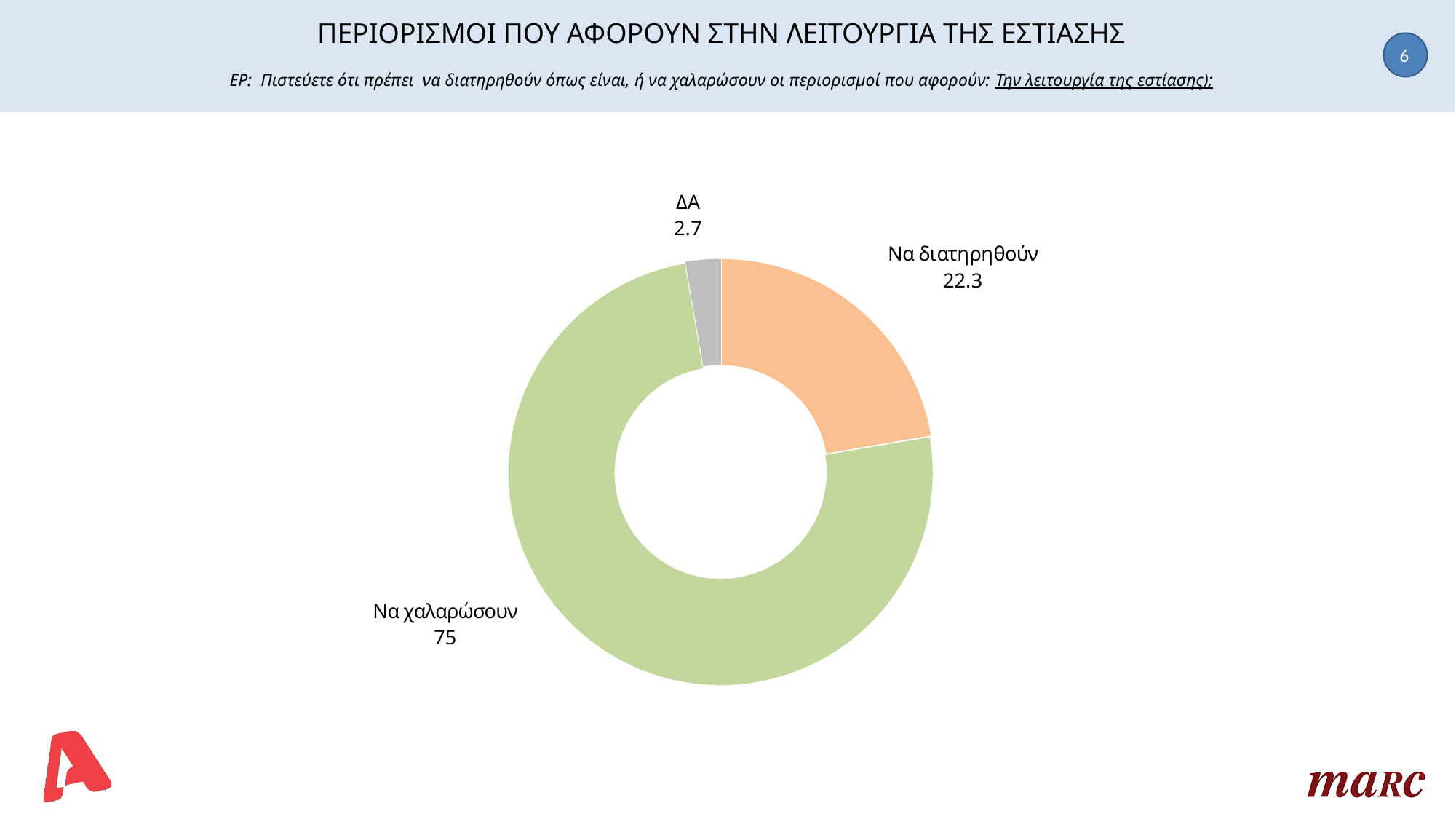
What kind of chart is shown on the slide? Doughnut (pie) chart What is the total of the three values shown in the chart? 100 What colour is the segment for Να χαλαρώσουν? Green Which category has the largest share of the chart? Να χαλαρώσουν Which is larger, the value for Να διατηρηθούν or the value for ΔΑ? Να διατηρηθούν What is the difference between the values for Να διατηρηθούν and ΔΑ? 19.6 What value is shown for Να χαλαρώσουν? 75 Which category has the smallest share of the chart? ΔΑ What value is shown for ΔΑ? 2.7 How many categories are shown in the chart? 3 What value is shown for Να διατηρηθούν? 22.3 What is the difference between the values for Να χαλαρώσουν and Να διατηρηθούν? 52.7